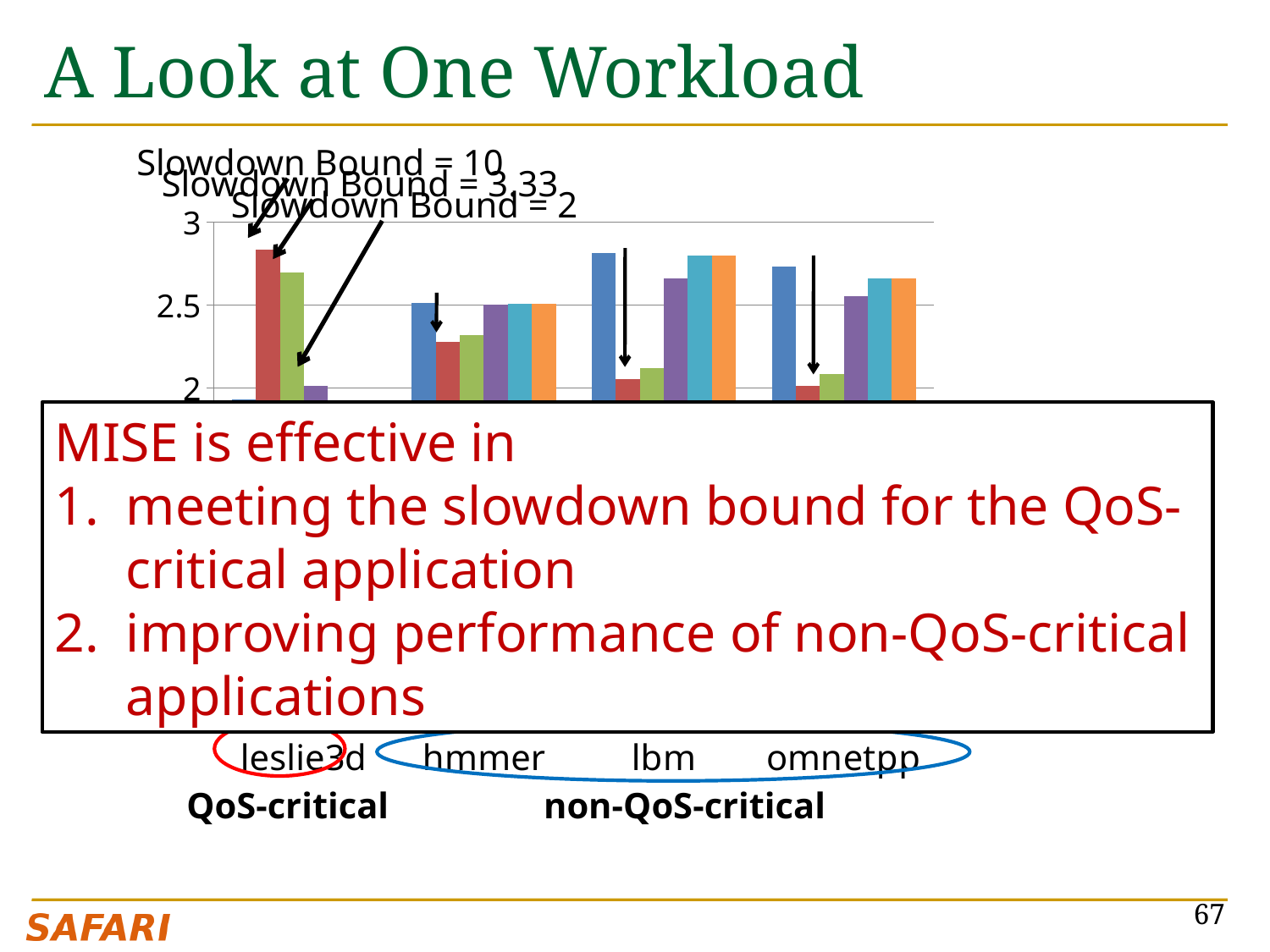
Which coloured bar is the lowest for lbm? red Is the value of the red bar for leslie3d greater or less than 2.5? greater How many application categories are shown on the x axis of the chart? 4 Is the value of the blue bar for lbm greater or less than 2.5? greater Is the value of the green bar for leslie3d greater or less than 2.5? greater What kind of chart is shown on the slide? bar chart Which applications on the x axis are grouped as non-QoS-critical? hmmer, lbm, omnetpp Which coloured bar is the highest for leslie3d? red Which application on the x axis is labelled as QoS-critical? leslie3d For omnetpp, is the blue bar or the red bar larger? blue